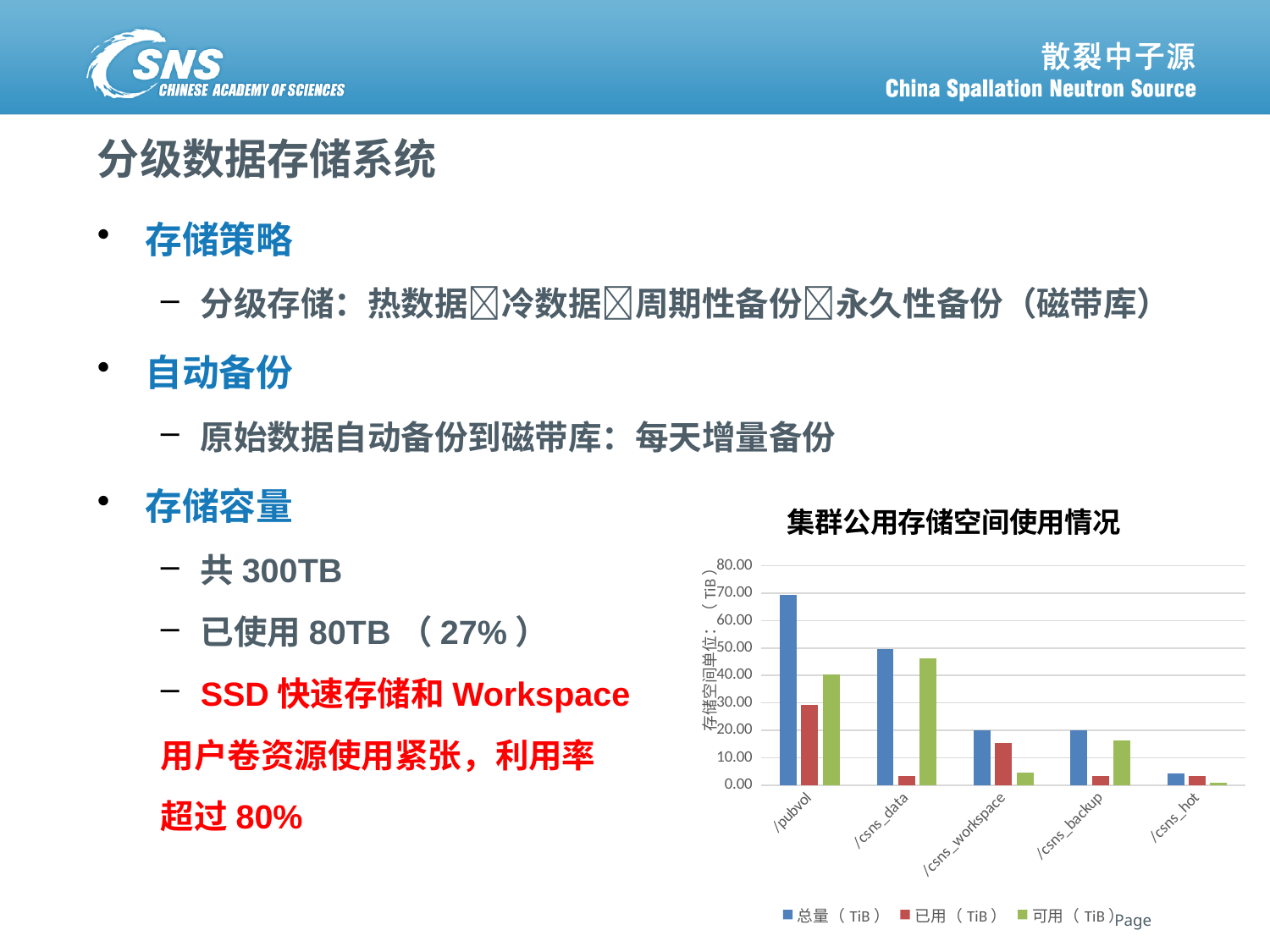
Is the 已用（TiB） value for /csns_data greater or less than 10? less Which category has the highest 已用（TiB） value? /pubvol Is the 总量（TiB） value for /pubvol greater or less than 60? greater Which category has the lowest 总量（TiB） value? /csns_hot Is the 总量（TiB） value for /csns_workspace greater or less than 30? less How many series does the chart's legend list? 3 How many categories are shown on the x axis of the chart? 5 Which is larger: the 已用（TiB） value for /pubvol or for /csns_workspace? /pubvol Which is larger: the 可用（TiB） value for /csns_data or for /csns_backup? /csns_data Which category has the highest 总量（TiB） value? /pubvol What kind of chart is shown on the slide? bar chart What is the title of the chart? 集群公用存储空间使用情况